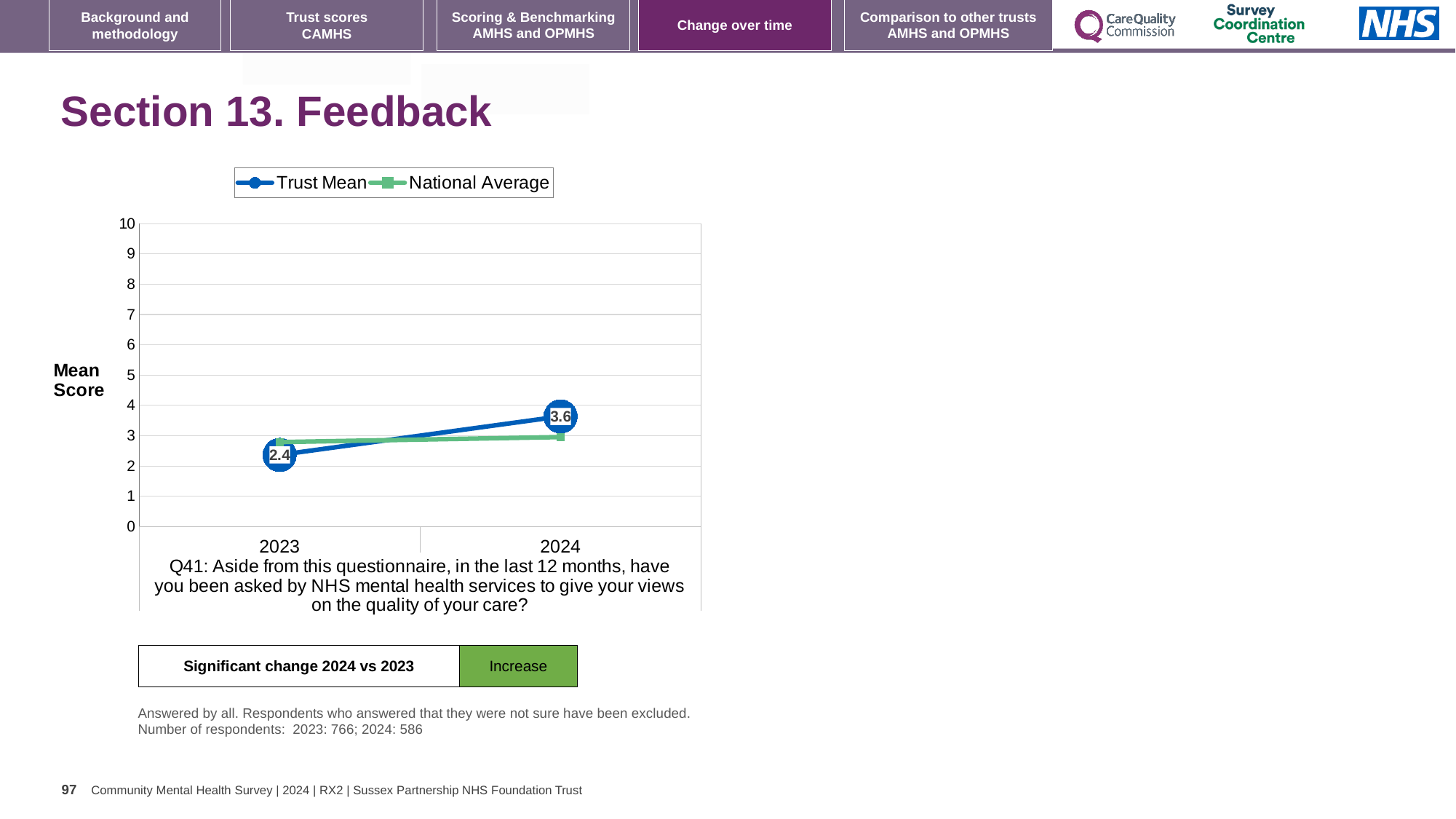
Is the National Average value for 2023 greater or less than 4? less What is the Trust Mean value for 2023? 2.4 Is the National Average value for 2024 greater or less than 2? greater In 2024, which series has the higher value, Trust Mean or National Average? Trust Mean How many series does the legend list? 2 In which year is the Trust Mean highest? 2024 What is the Trust Mean value for 2024? 3.6 What kind of chart is shown on the slide? Line chart How many years are shown on the x axis? 2 What is the difference between the Trust Mean in 2024 and in 2023? 1.2 In which year is the Trust Mean lowest? 2023 Which is larger, the Trust Mean for 2023 or for 2024? 2024